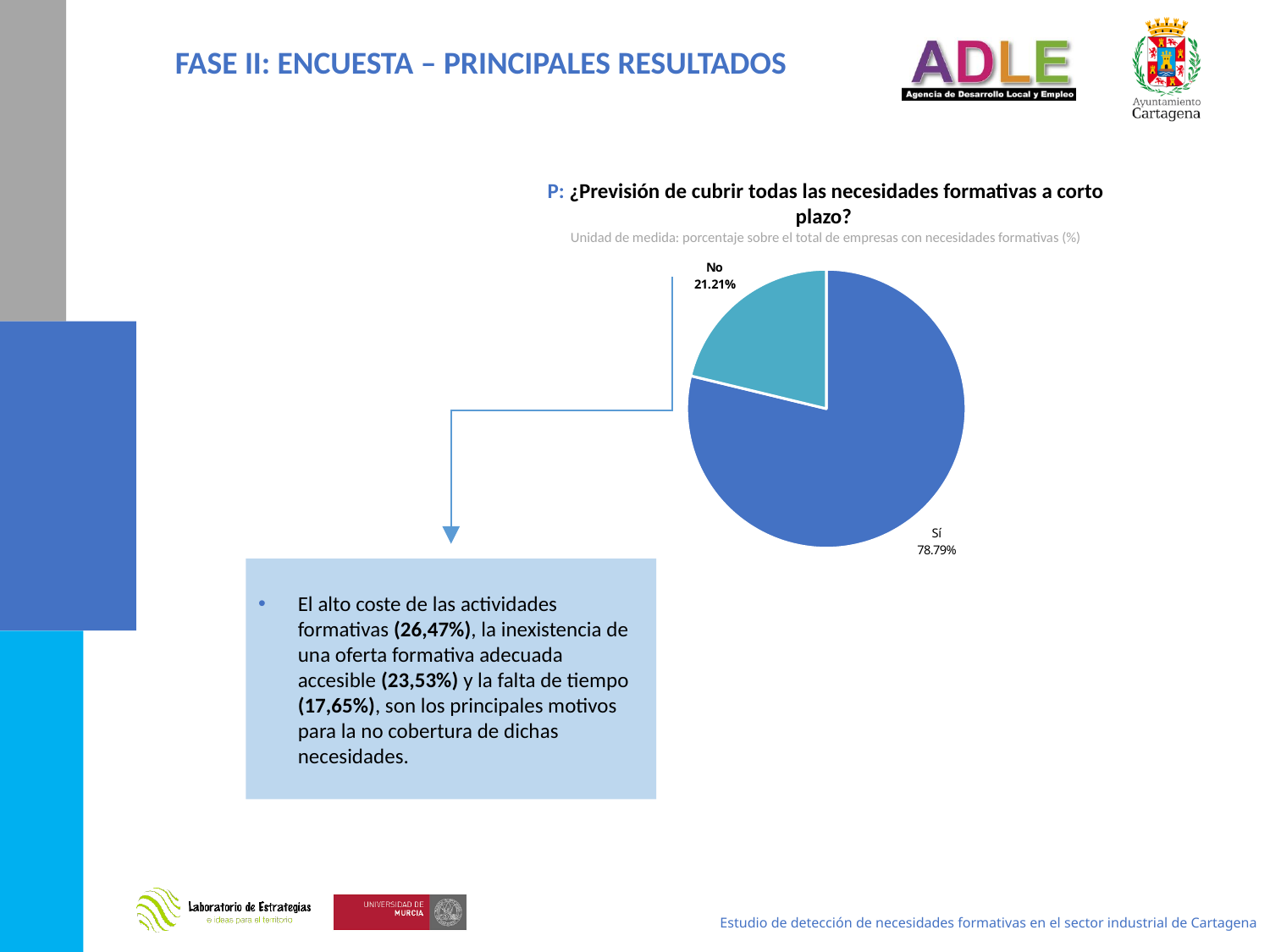
What question does the chart title ask? ¿Previsión de cubrir todas las necesidades formativas a corto plazo? What percentage of companies answered "Sí" in the pie chart? 78.79% What share of the pie does the "No" slice represent? 21.21% What is the difference in percentage points between the "Sí" and "No" slices? 57.58 Which is larger in the pie chart, "Sí" or "No"? Sí How many slices does the pie chart have? 2 What percentage of companies answered "No" in the pie chart? 21.21% Which slice of the pie chart is the largest? Sí What type of chart is shown on the slide? Pie chart Which slice of the pie chart is the smallest? No What colour is the "Sí" slice of the pie chart? Blue